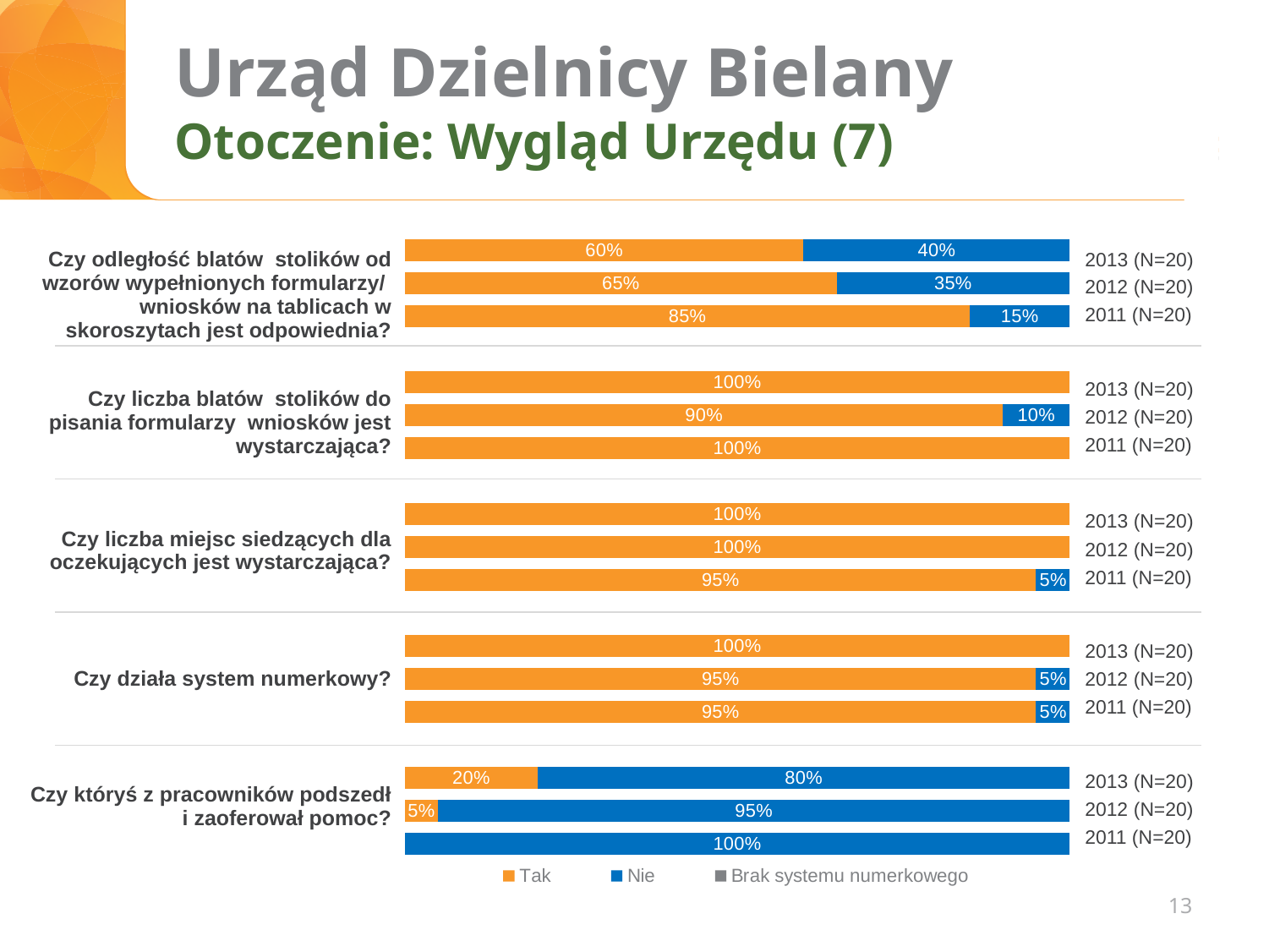
What percentage answered "Tak" in 2013 to "Czy odległość blatów stolików od wzorów wypełnionych formularzy/wniosków na tablicach w skoroszytach jest odpowiednia?"? 60% What percentage answered "Tak" in 2013 to "Czy któryś z pracowników podszedł i zaoferował pomoc?"? 20% For "Czy odległość blatów stolików od wzorów wypełnionych formularzy/wniosków na tablicach w skoroszytach jest odpowiednia?", which year had the highest "Tak" share? 2011 How many series does the legend list? 3 What percentage answered "Nie" in 2012 to "Czy liczba blatów stolików do pisania formularzy wniosków jest wystarczająca?"? 10% For "Czy odległość blatów stolików od wzorów wypełnionych formularzy/wniosków na tablicach w skoroszytach jest odpowiednia?", what is the difference between the "Tak" share in 2011 and in 2013? 25 percentage points What percentage answered "Nie" in 2011 to "Czy któryś z pracowników podszedł i zaoferował pomoc?"? 100% For "Czy któryś z pracowników podszedł i zaoferował pomoc?", which is larger: the "Nie" share in 2013 or in 2012? 2012 What kind of chart is shown on the slide? Stacked bar chart How many survey questions are shown on the chart? 5 What is the sample size (N) shown for each year? N=20 What percentage answered "Nie" in 2011 to "Czy odległość blatów stolików od wzorów wypełnionych formularzy/wniosków na tablicach w skoroszytach jest odpowiednia?"? 15%